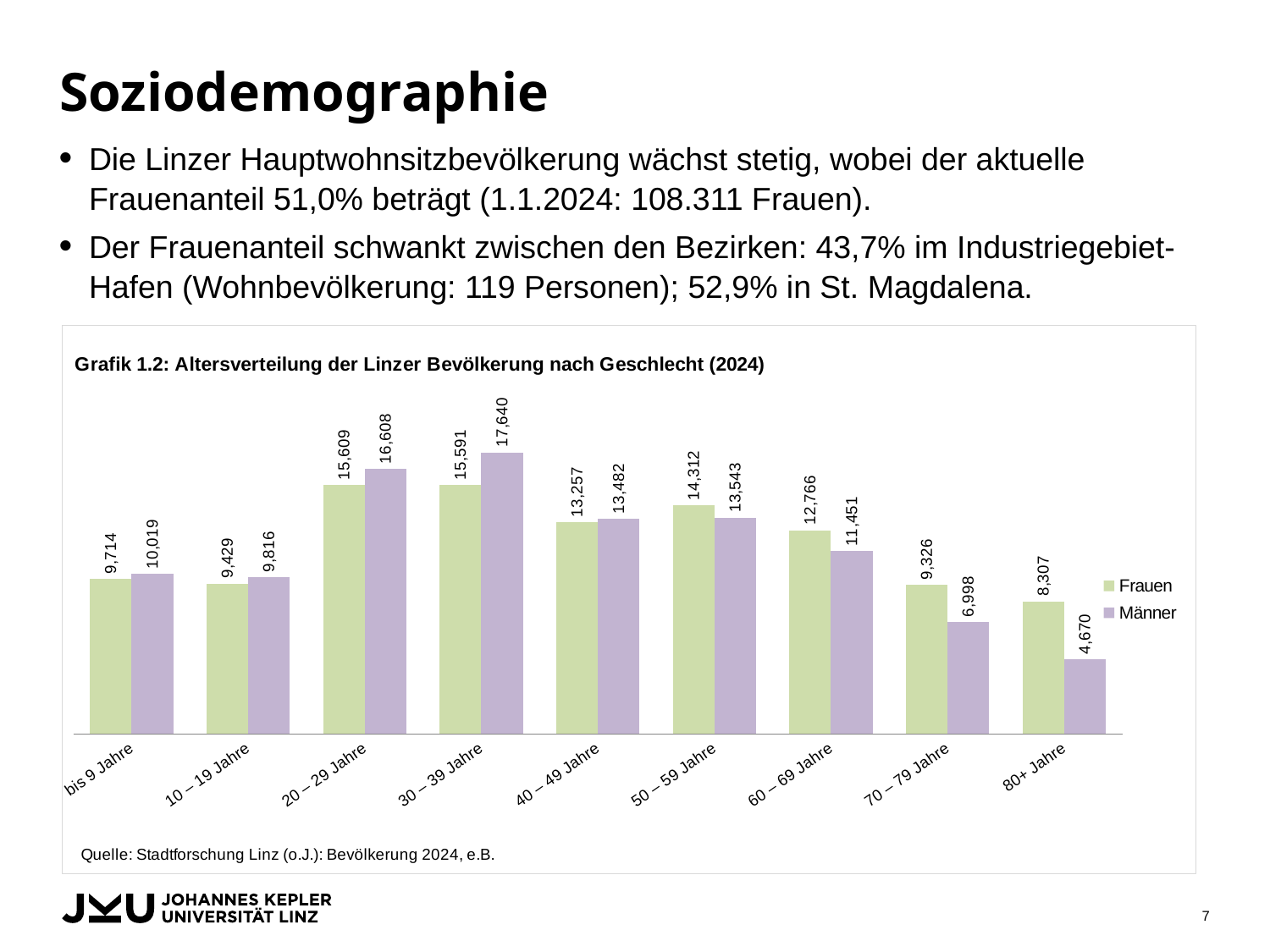
What is the difference between the Männer and Frauen values in the 30 – 39 Jahre age group? 2,049 Which age group has the lowest value for Frauen? 80+ Jahre How many series does the legend list? 2 What is the title of the chart? Grafik 1.2: Altersverteilung der Linzer Bevölkerung nach Geschlecht (2024) Which age group has the highest value for Männer? 30 – 39 Jahre How many age groups are shown on the x axis? 9 What is the value for Männer in the 60 – 69 Jahre age group? 11,451 What kind of chart is shown on the slide? Bar chart What is the difference between the Frauen and Männer values in the 80+ Jahre age group? 3,637 In the 50 – 59 Jahre age group, which is larger: Frauen or Männer? Frauen What is the value for Männer in the 80+ Jahre age group? 4,670 What is the value for Frauen in the 30 – 39 Jahre age group? 15,591